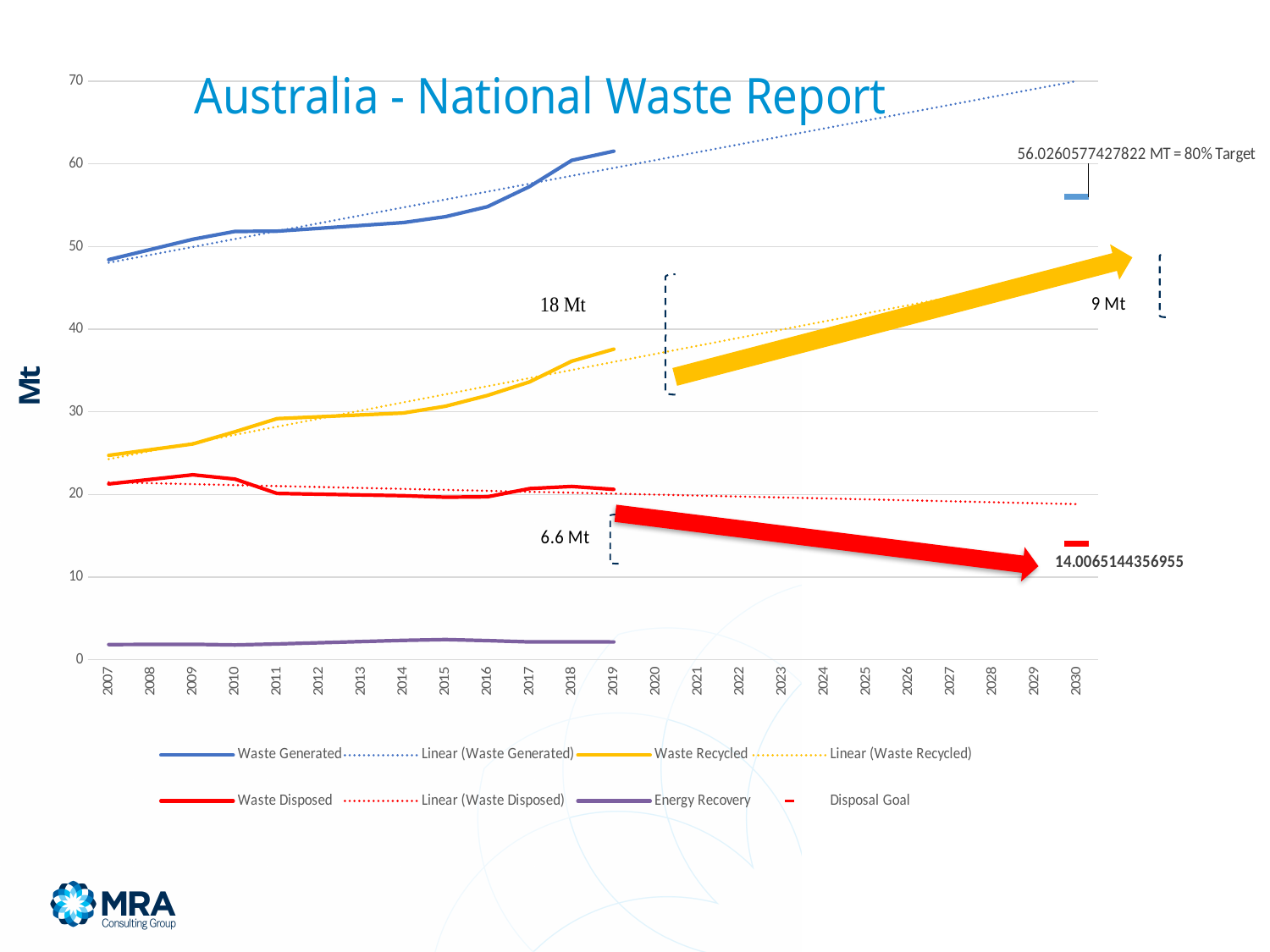
What value is printed next to the Disposal Goal marker on the chart? 14.0065144356955 Is the value for Waste Recycled in 2019 greater or less than 40? less Which series has the highest value in 2019? Waste Generated What value is labelled as the 80% Target on the chart? 56.0260577427822 MT How many years are shown along the x axis of the chart? 24 What is the title of the chart? Australia - National Waste Report Is the value for Energy Recovery in 2015 greater or less than 10? less Does the Waste Generated line rise or fall from 2007 to 2019? rise Is the value for Waste Generated in 2019 greater or less than 60? greater What kind of chart is shown on the slide? line chart What label is shown on the vertical axis of the chart? Mt How many entries does the chart legend list? 8